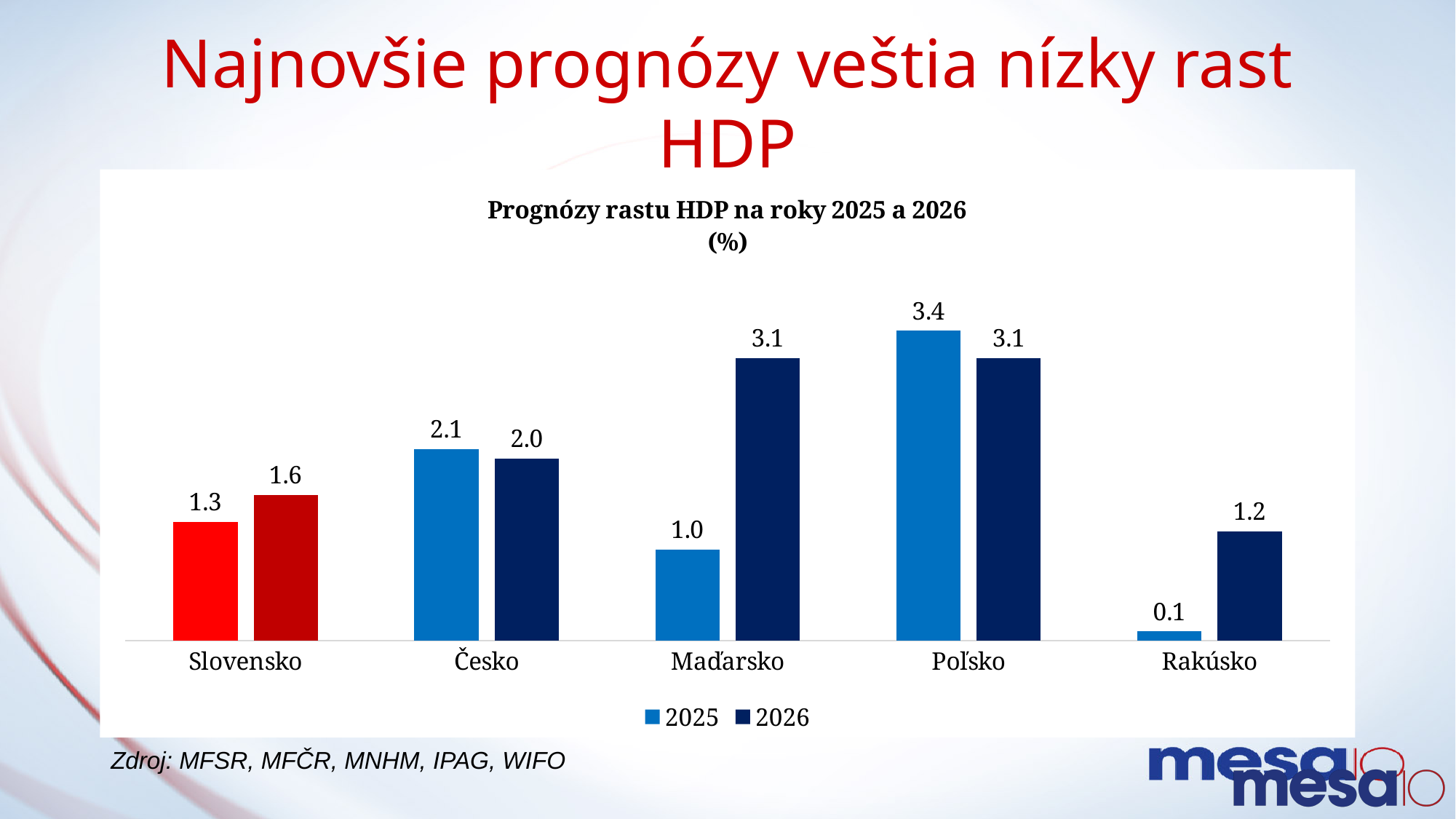
What is the 2026 GDP growth forecast for Maďarsko? 3.1 What is the 2025 GDP growth forecast for Slovensko? 1.3 Which country has the lowest 2026 forecast? Rakúsko Which is larger for Česko: the 2025 or the 2026 forecast? 2025 What is the title of the chart? Prognózy rastu HDP na roky 2025 a 2026 (%) What is the difference between the 2026 and 2025 forecasts for Maďarsko? 2.1 How many series does the legend list? 2 What kind of chart is shown on the slide? bar chart What is the 2025 value for Rakúsko? 0.1 Which country has the highest 2025 forecast? Poľsko Which country's bars are coloured red instead of blue? Slovensko How many countries are shown on the x axis? 5